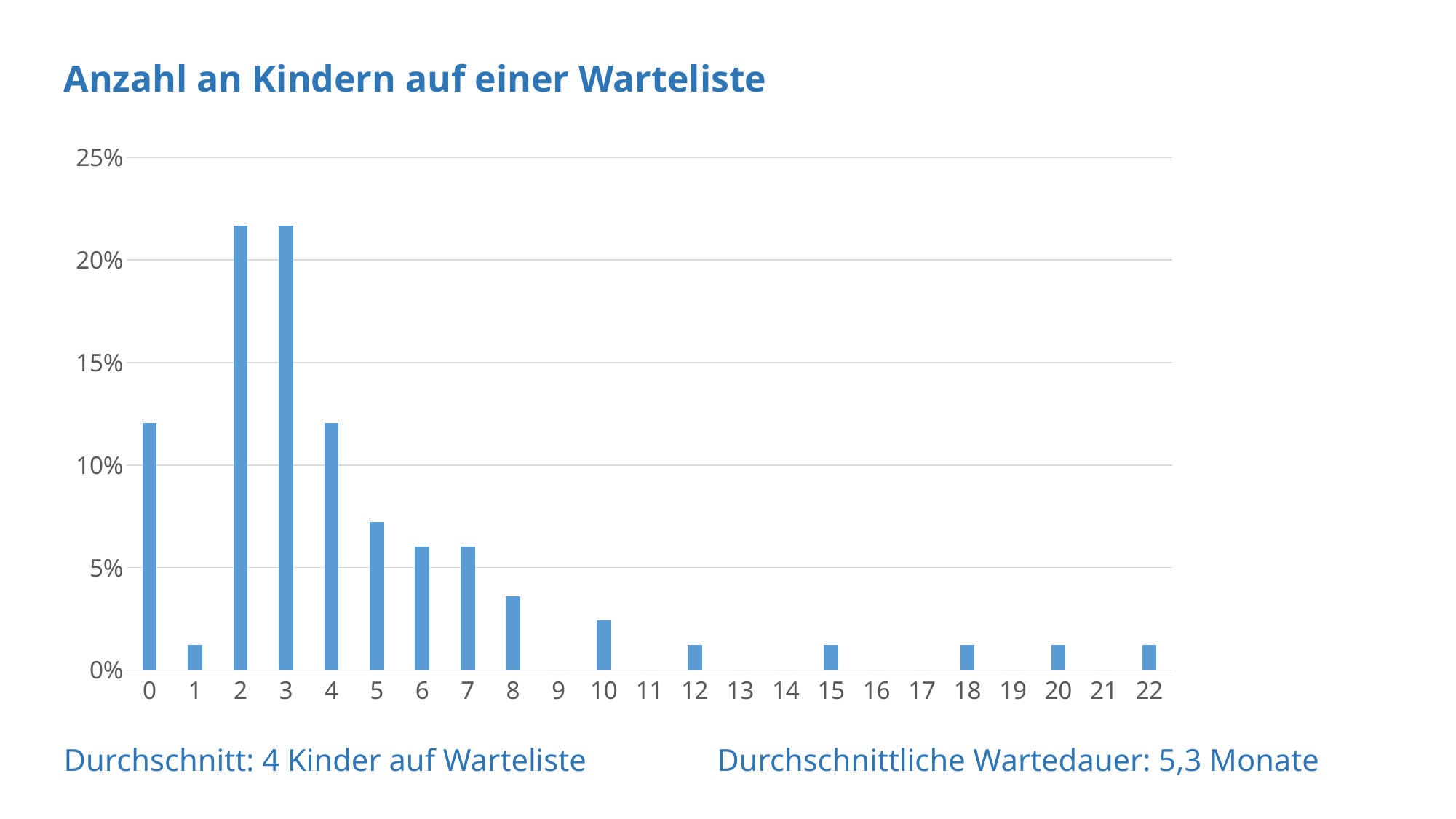
Do the values rise or fall along the x axis from category 4 to category 8? fall What kind of chart is shown on the slide? bar chart Is the value for category 0 greater or less than 10%? greater Is the value for category 5 greater or less than 5%? greater Which has the larger value, category 2 or category 4? 2 Which has the larger value, category 5 or category 8? 5 Is the value for category 8 greater or less than 5%? less According to the text below the chart, what is the average number of children on the waiting list? 4 Kinder What is the title of the chart? Anzahl an Kindern auf einer Warteliste How many categories are shown on the x axis of the chart? 23